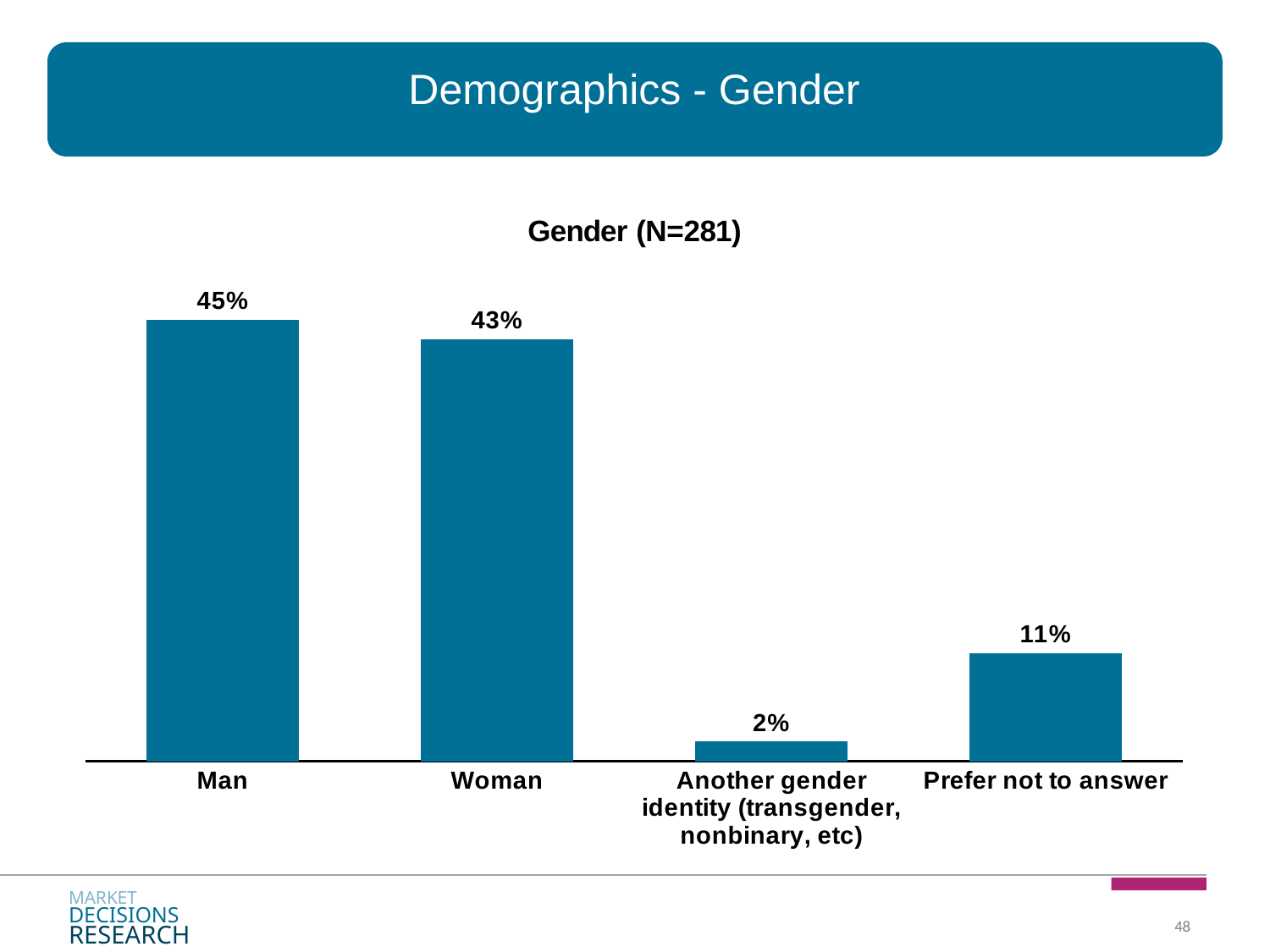
Which is larger, the percentage for Woman or for Prefer not to answer? Woman What is the sample size (N) given in the chart title? 281 How many categories are shown in the chart? 4 What is the difference in percentage points between Man and Woman? 2 Which category has the highest percentage? Man What percentage of respondents identified as Man? 45% What is the difference in percentage points between Prefer not to answer and Another gender identity? 9 What type of chart is shown on the slide? Bar chart What percentage of respondents selected Another gender identity (transgender, nonbinary, etc)? 2% What percentage of respondents chose Prefer not to answer? 11% Which category has the lowest percentage? Another gender identity (transgender, nonbinary, etc) What percentage of respondents identified as Woman? 43%